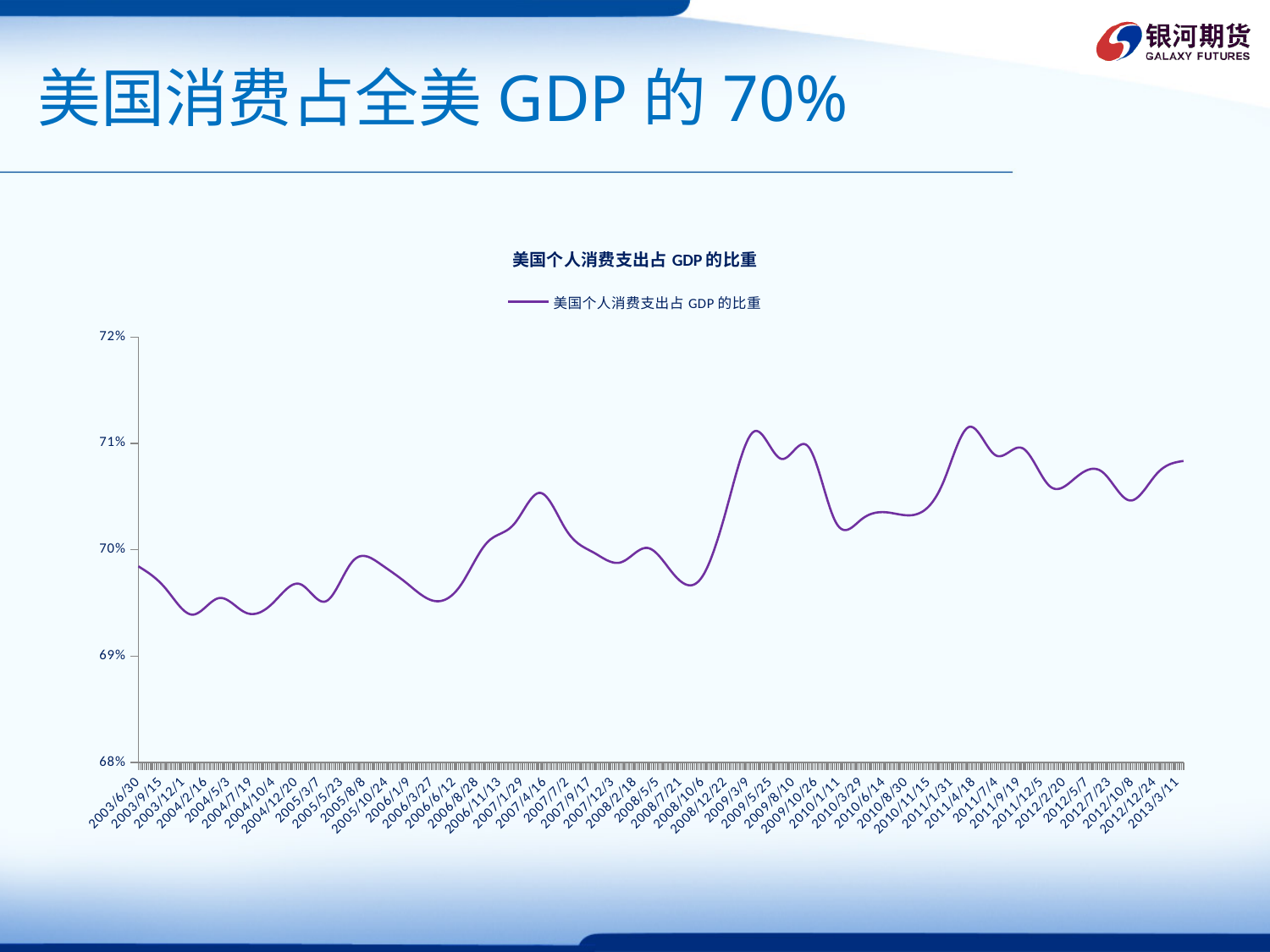
Is the value for 2004/2/16 greater or less than 70%? less Is the value for 2003/6/30 greater or less than 70%? less What is the title of the chart? 美国个人消费支出占 GDP 的比重 Which is larger, the value for 2009/3/9 or the value for 2003/6/30? 2009/3/9 Overall, does the line rise or fall from 2003/6/30 to 2013/3/11? rise Is the value for 2008/10/6 greater or less than 70%? less How many series does the chart's legend list? 1 What kind of chart is shown on the slide? line chart What is the legend entry for the plotted line? 美国个人消费支出占 GDP 的比重